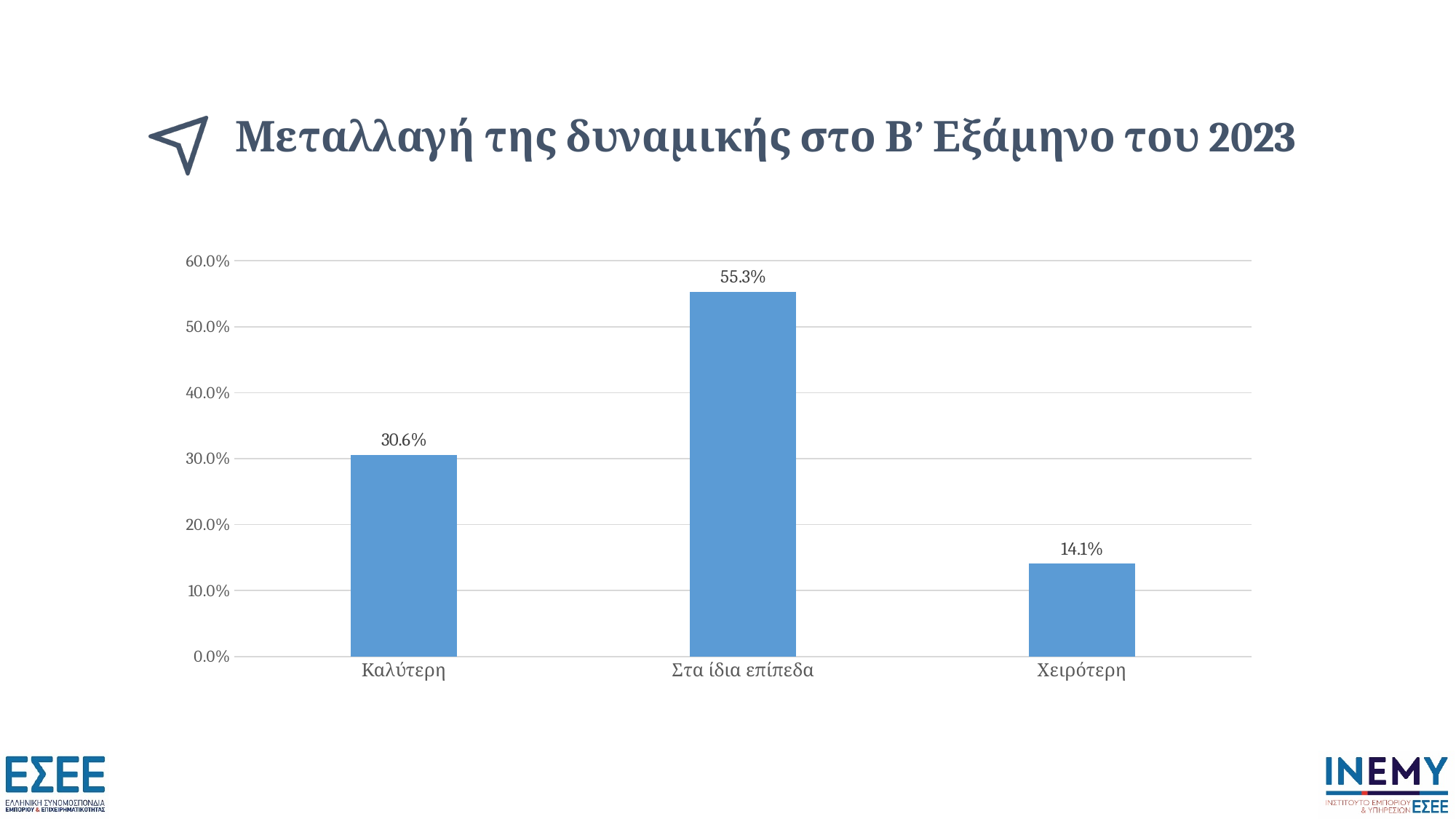
Is the value for Στα ίδια επίπεδα greater or less than 50.0%? greater What is the difference between the values for Στα ίδια επίπεδα and Καλύτερη? 24.7% Which category has the lowest value? Χειρότερη What is the difference between the values for Καλύτερη and Χειρότερη? 16.5% What is the value for Στα ίδια επίπεδα? 55.3% What is the title of the slide? Μεταλλαγή της δυναμικής στο Β' Εξάμηνο του 2023 Which is larger, the value for Καλύτερη or the value for Χειρότερη? Καλύτερη Which category has the highest value? Στα ίδια επίπεδα What is the value for Χειρότερη? 14.1% What kind of chart is shown on the slide? Bar chart What is the value for Καλύτερη? 30.6% How many categories are shown on the chart? 3